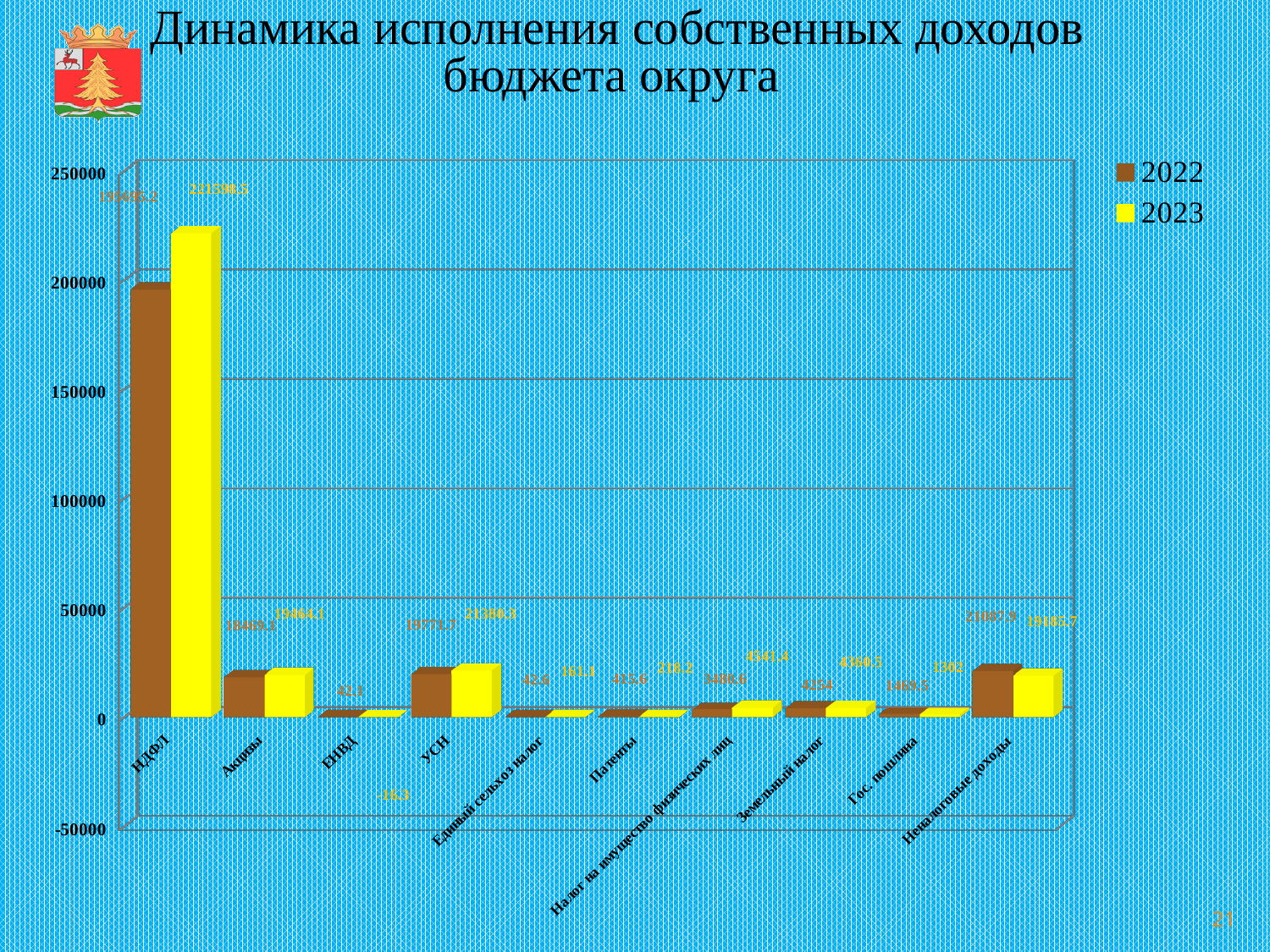
Which years are listed in the legend? 2022 and 2023 What is the 2023 value for ЕНВД? -16.3 How many categories are shown on the x axis? 10 Which category has the highest value for 2023? НДФЛ What kind of chart is shown on the slide? Bar chart How many series does the legend list? 2 For УСН, which year has the larger value, 2022 or 2023? 2023 For НДФЛ, which year has the larger value, 2022 or 2023? 2023 Is the 2022 value for Акцизы greater or less than 50000? less What is the title of the chart? Динамика исполнения собственных доходов бюджета округа Is the 2023 value for НДФЛ greater or less than 200000? greater Which category has the highest value for 2022? НДФЛ